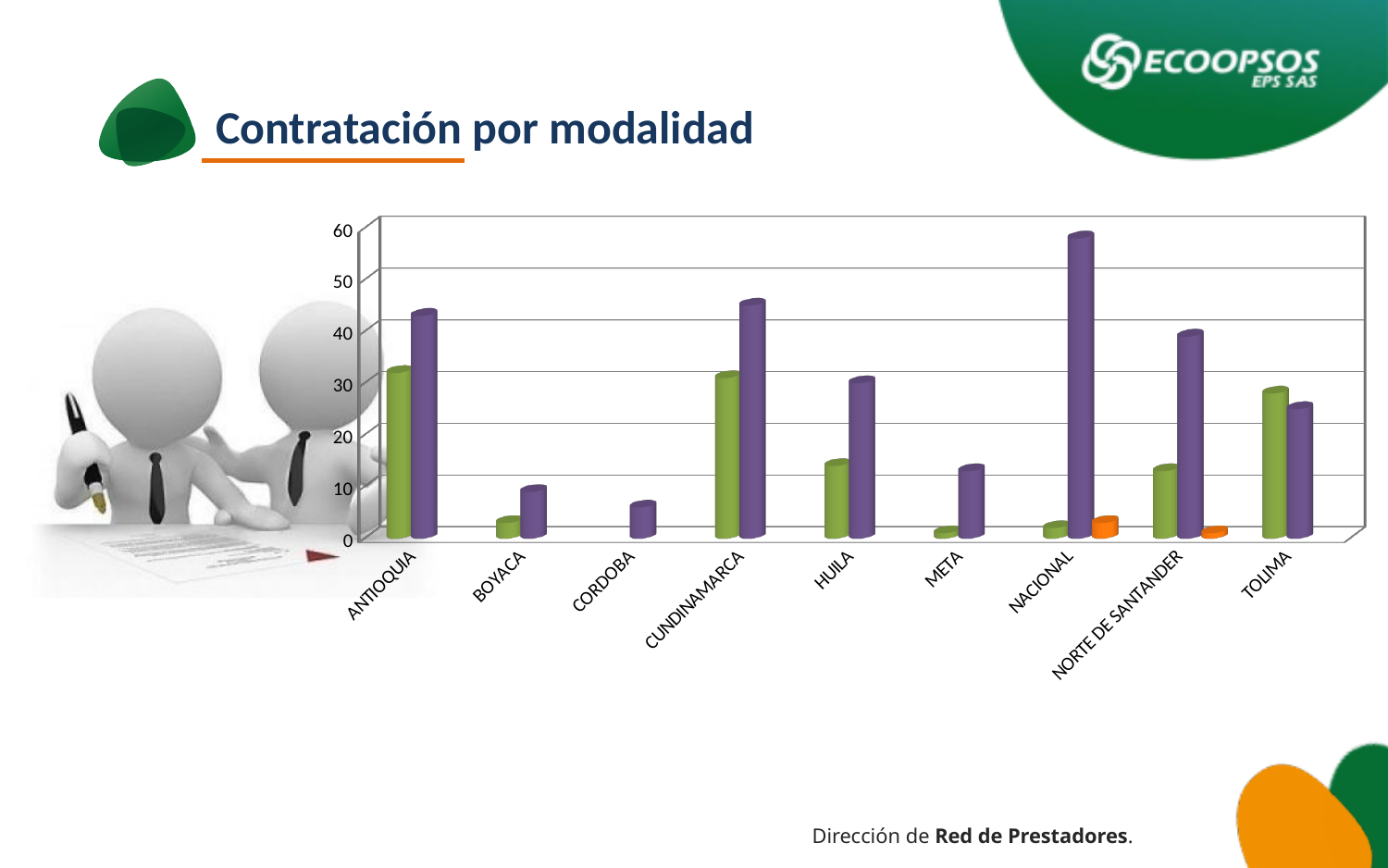
Which is larger, the purple bar for NACIONAL or the purple bar for CUNDINAMARCA? NACIONAL Is the green bar for TOLIMA greater or less than 20? greater Which category has the tallest purple bar in the chart? NACIONAL Which is larger, the green bar for ANTIOQUIA or the green bar for HUILA? ANTIOQUIA Is the purple bar for ANTIOQUIA greater or less than 40? greater Which is larger, the purple bar for HUILA or the purple bar for META? HUILA For which categories does the chart show an orange bar? NACIONAL and NORTE DE SANTANDER Is the purple bar for NACIONAL greater or less than 50? greater How many categories are shown on the x axis of the chart? 9 What kind of chart is shown on the slide? bar chart